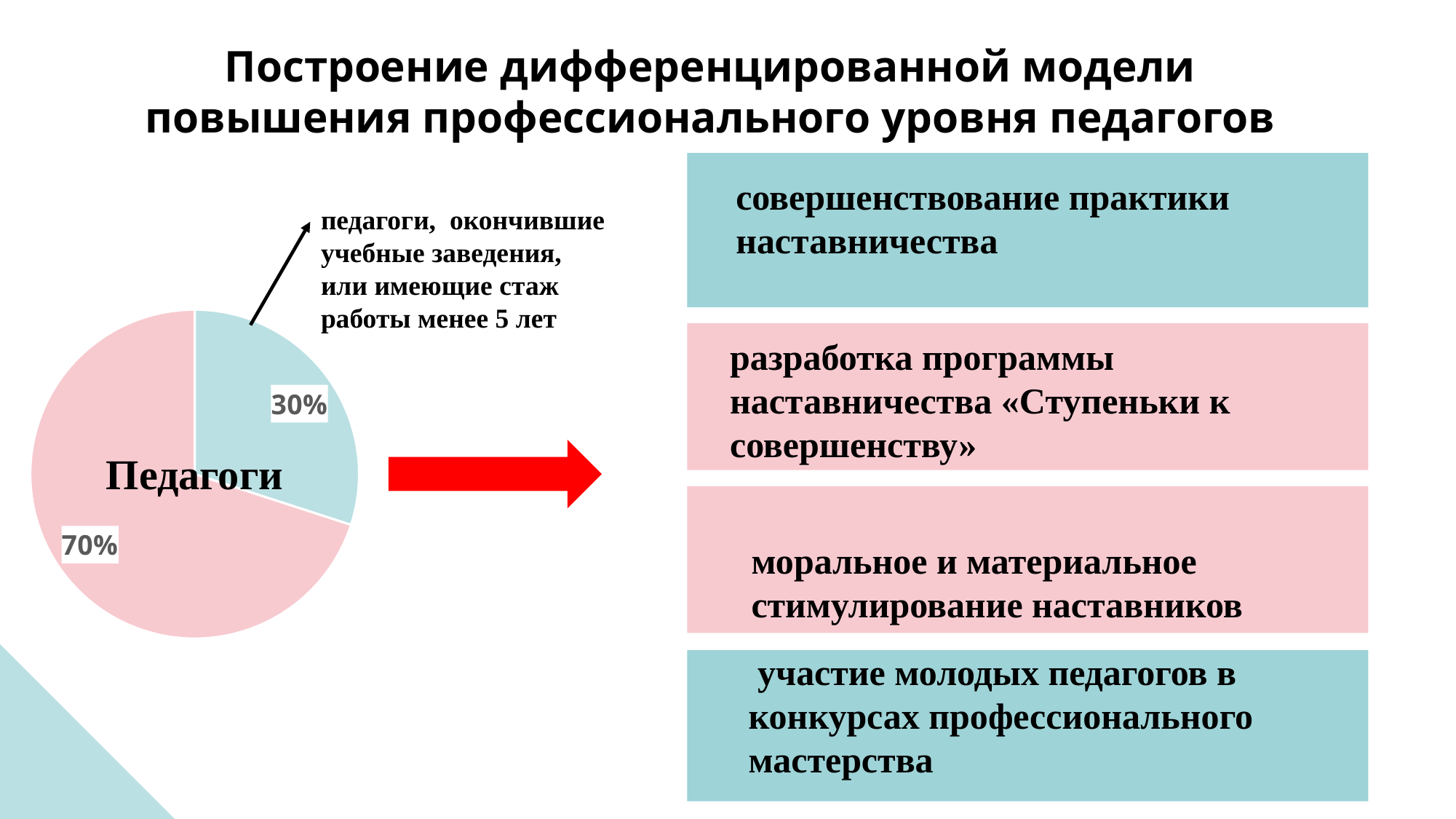
Which is larger: the pink slice or the light blue slice? the pink slice What label is written in the centre of the pie chart? Педагоги What share of the pie is taken by teachers who graduated from educational institutions or have less than 5 years of work experience? 30% How many slices does the pie chart have? 2 What percentage is shown on the light blue slice of the pie chart? 30% What kind of chart is shown on the slide? pie chart What colour is the 30% slice of the pie chart? light blue Is the value of the light blue slice greater or less than 50%? less Which slice of the pie chart is the largest? 70% What is the difference between the two slices of the pie chart? 40% Which slice of the pie chart is the smallest? 30% What percentage is shown on the pink slice of the pie chart? 70%